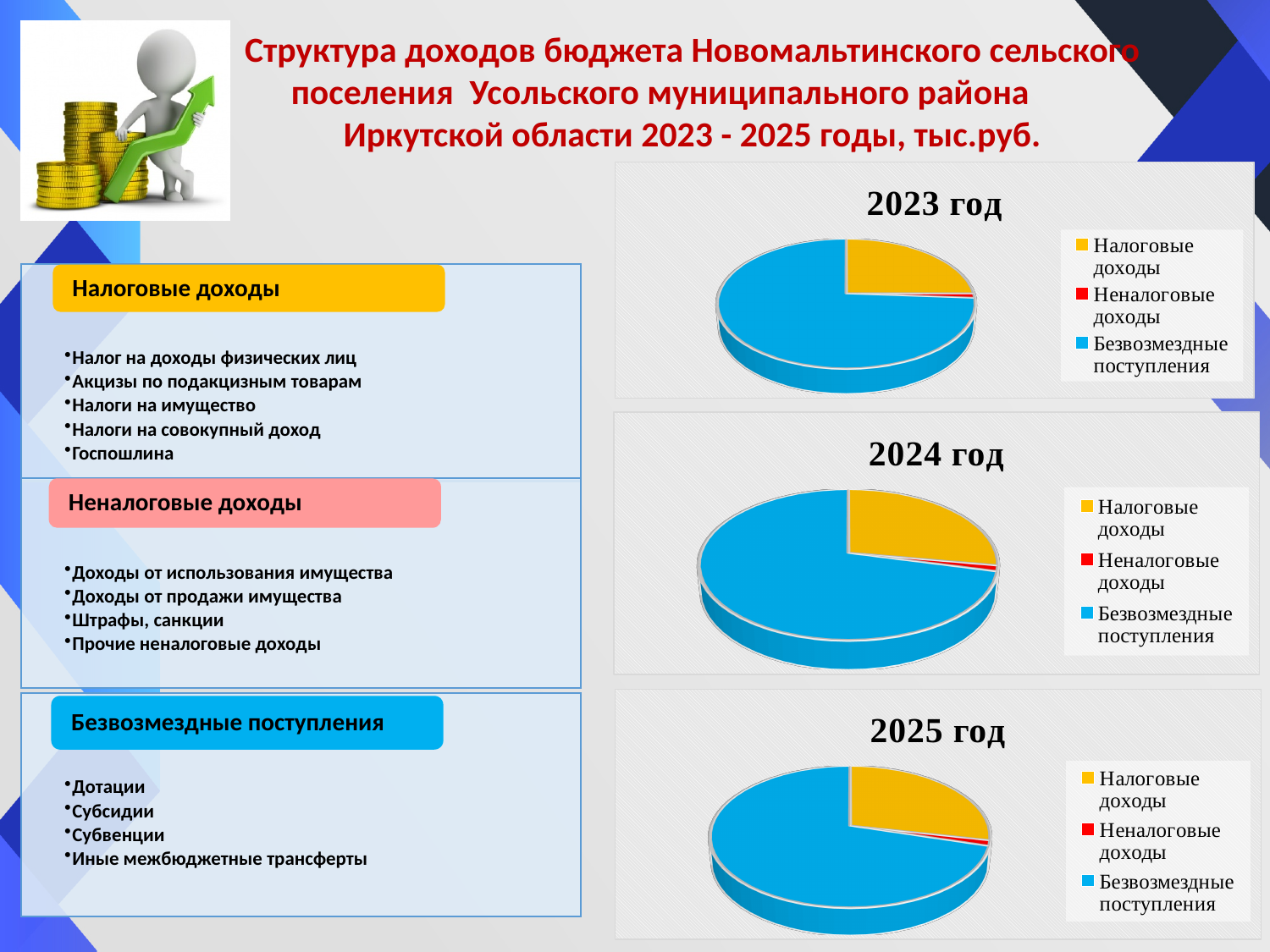
How many charts are shown on the slide? 3 In the "2023 год" chart, which category has the largest slice? Безвозмездные поступления In the "2025 год" chart, which category has the smallest slice? Неналоговые доходы In the "2024 год" chart, which slice is larger: Налоговые доходы or Неналоговые доходы? Налоговые доходы In the "2023 год" chart, which category has the smallest slice? Неналоговые доходы How many entries does the legend of the "2024 год" chart list? 3 How many slices does the "2025 год" pie chart have? 3 What is the title of the bottom chart on the slide? 2025 год In the "2024 год" chart, which category has the largest slice? Безвозмездные поступления In the "2025 год" chart, which slice is larger: Налоговые доходы or Безвозмездные поступления? Безвозмездные поступления What kind of chart is the "2023 год" chart? pie chart What colour represents Безвозмездные поступления in the "2023 год" chart? blue